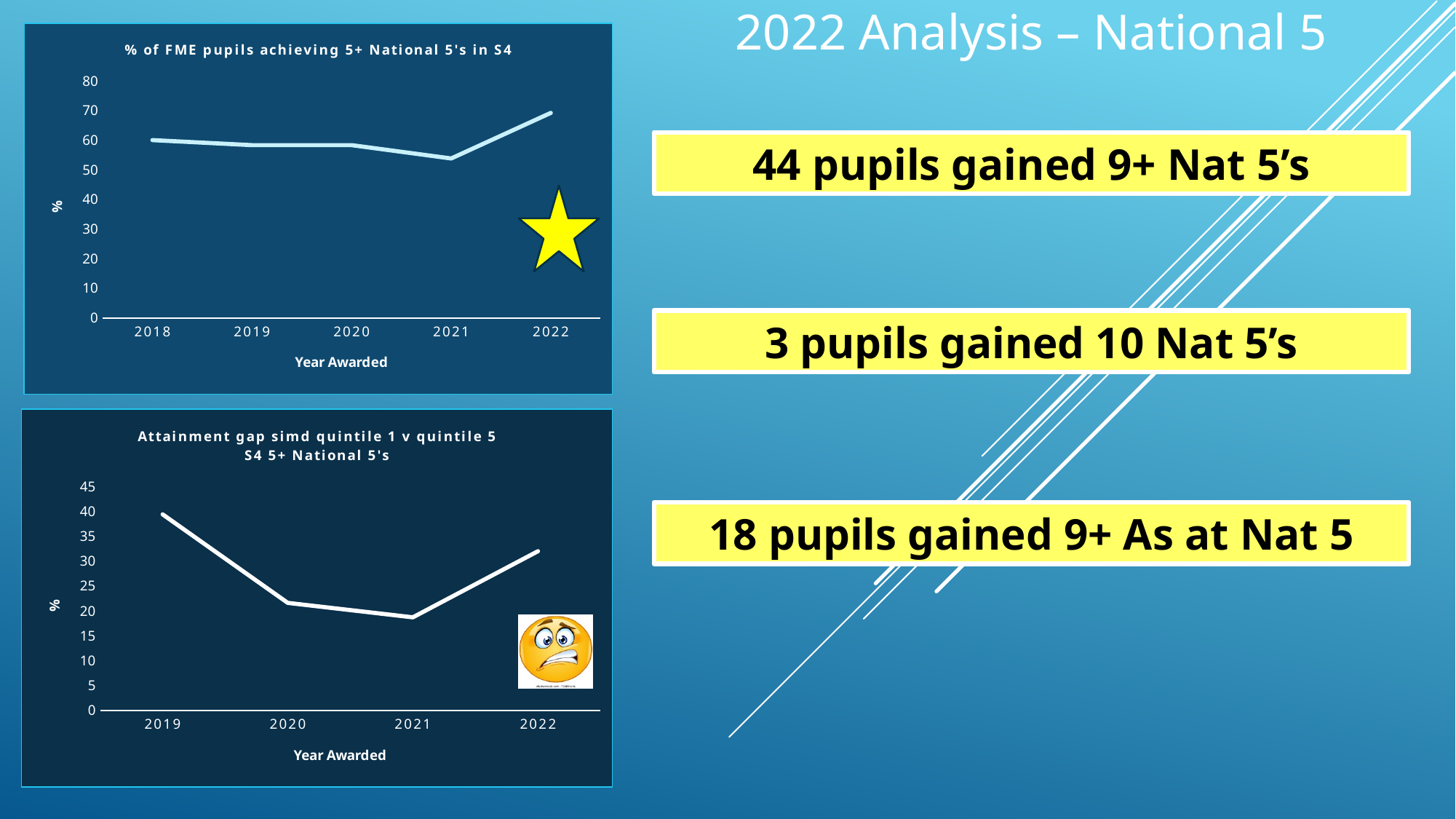
In the bottom chart, 'Attainment gap simd quintile 1 v quintile 5', which year has the highest value? 2019 In the bottom chart, 'Attainment gap simd quintile 1 v quintile 5', which year has the lowest value? 2021 In the top chart, '% of FME pupils achieving 5+ National 5's in S4', is the value for 2022 greater or less than 60? greater In the top chart, '% of FME pupils achieving 5+ National 5's in S4', which year has the lowest value? 2021 In the bottom chart, 'Attainment gap simd quintile 1 v quintile 5', how many years are plotted on the x axis? 4 What kind of chart is the bottom chart, 'Attainment gap simd quintile 1 v quintile 5 S4 5+ National 5's'? Line chart What is the x-axis label on the top chart, '% of FME pupils achieving 5+ National 5's in S4'? Year Awarded In the top chart, '% of FME pupils achieving 5+ National 5's in S4', how many years are plotted on the x axis? 5 What kind of chart is the top chart, '% of FME pupils achieving 5+ National 5's in S4'? Line chart In the bottom chart, 'Attainment gap simd quintile 1 v quintile 5', which is larger, the value for 2019 or the value for 2022? 2019 In the top chart, '% of FME pupils achieving 5+ National 5's in S4', which year has the highest value? 2022